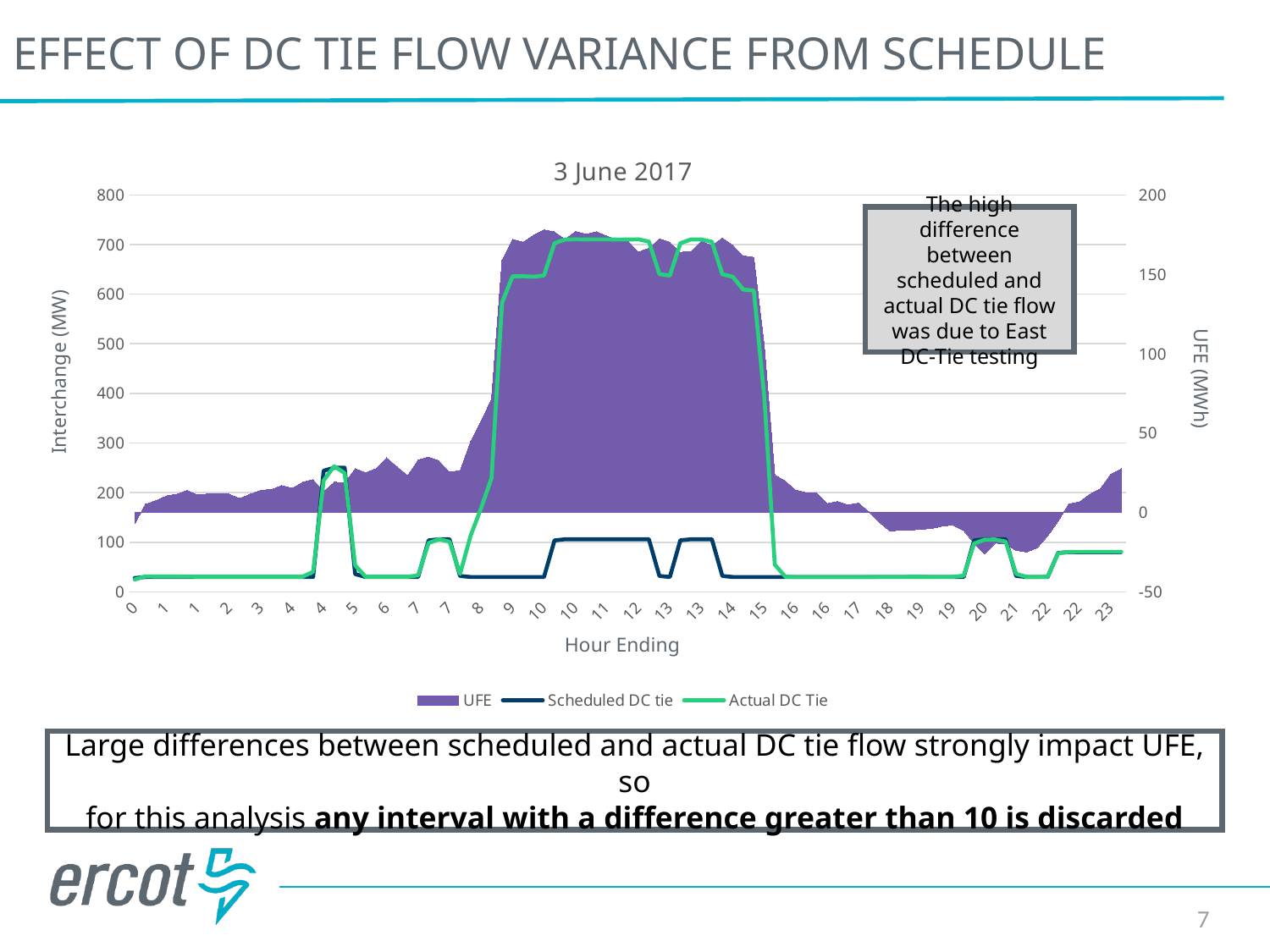
How many series does the chart legend list? 3 What is the title of the chart? 3 June 2017 Does the Actual DC Tie line rise or fall between hour ending 8 and hour ending 9? rise Is the Actual DC Tie value at hour ending 18 greater or less than 100 MW? less Is the Actual DC Tie value at hour ending 0 greater or less than 100 MW? less Does the Actual DC Tie line rise or fall between hour ending 15 and hour ending 16? fall Is the Actual DC Tie value at hour ending 11 greater or less than 600 MW? greater What are the three series named in the chart legend? UFE, Scheduled DC tie, Actual DC Tie At hour ending 11, which is larger: the Actual DC Tie or the Scheduled DC tie? Actual DC Tie What kind of chart is shown on the slide? A combination chart with a shaded area (UFE) and two line series Which series reaches the highest level on the left Interchange (MW) axis? Actual DC Tie